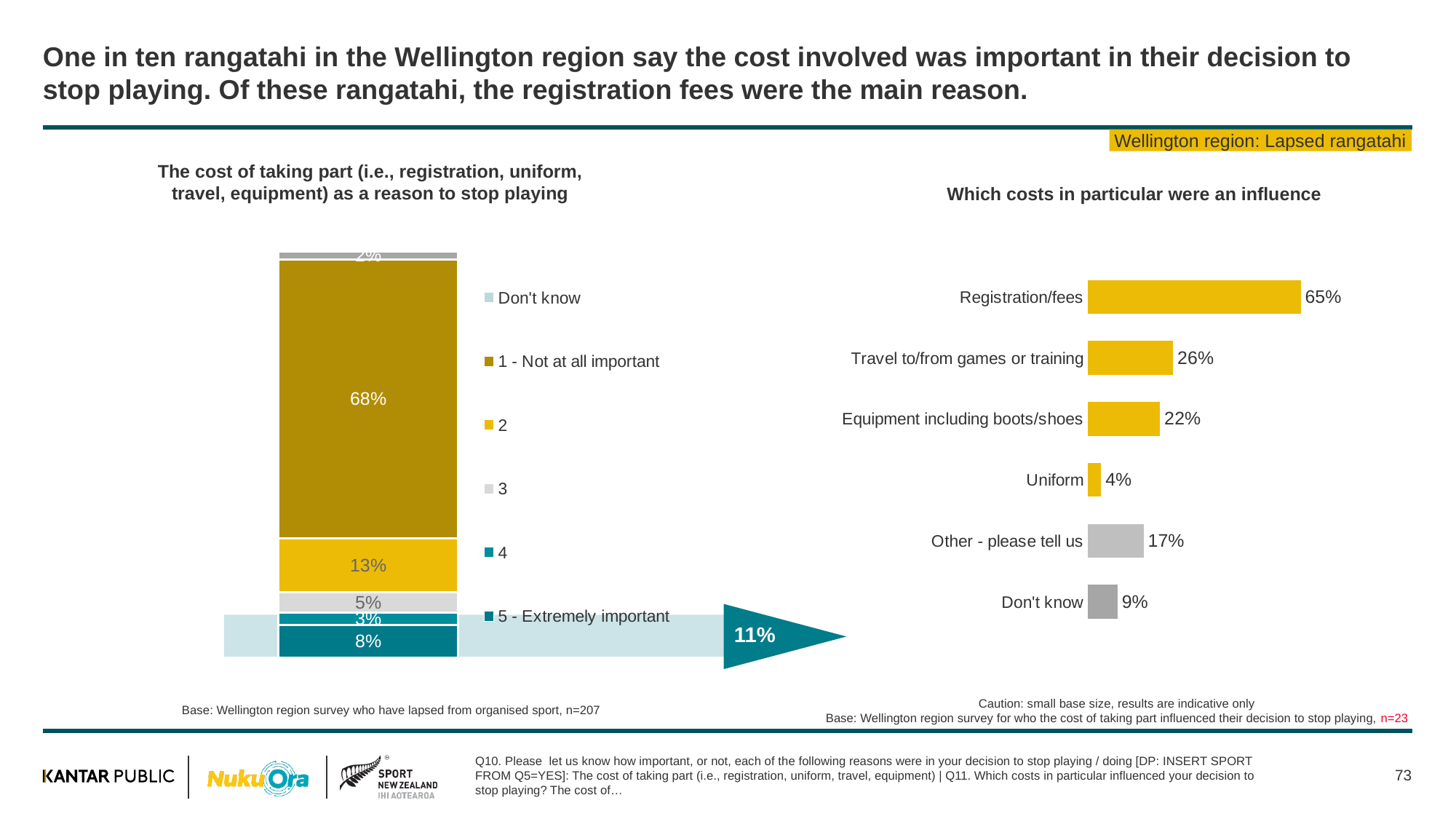
In the chart 'Which costs in particular were an influence', what is the difference between Registration/fees and Equipment including boots/shoes? 43% In the chart 'Which costs in particular were an influence', which category has the highest value? Registration/fees In the chart 'Which costs in particular were an influence', which category has the lowest value? Uniform How many entries does the legend of the stacked bar chart on the left list? 6 In the stacked bar chart on the left, what is the combined value of segments 4 and 5 shown in the arrow? 11% In the chart 'Which costs in particular were an influence', what is the value for Travel to/from games or training? 26% In the stacked bar chart on the left, what is the value for '5 - Extremely important'? 8% In the stacked bar chart on the left, what is the value for '1 - Not at all important'? 68% How many categories are shown in the chart 'Which costs in particular were an influence'? 6 What type of chart is 'Which costs in particular were an influence'? Bar chart In the chart 'Which costs in particular were an influence', which is larger: Other - please tell us or Don't know? Other - please tell us In the chart 'Which costs in particular were an influence', what is the value for Registration/fees? 65%